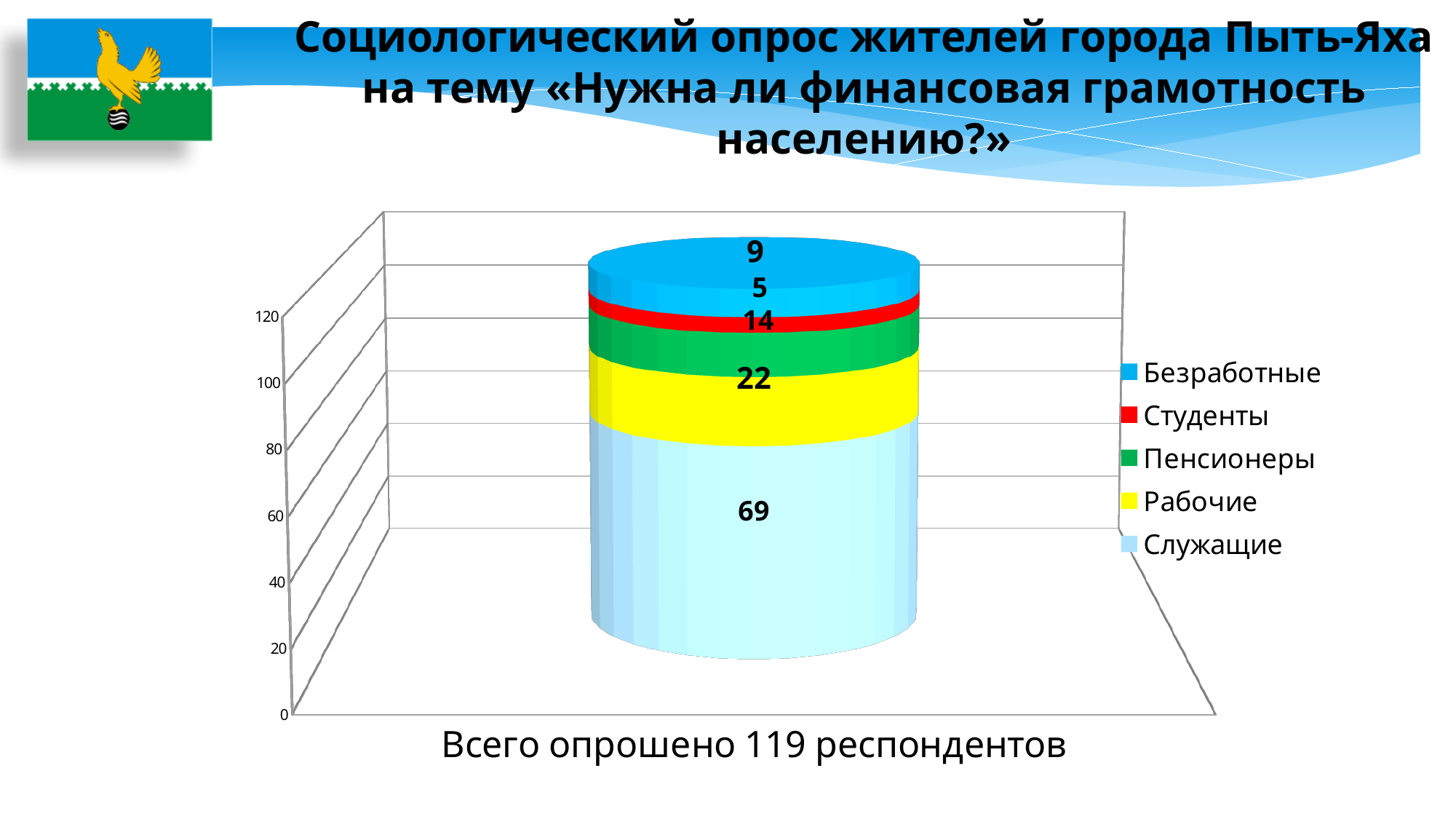
Which group has the smallest value in the chart? Студенты What kind of chart is shown on the slide? Stacked bar chart What value is shown for Безработные in the stacked bar? 9 What value is shown for Служащие in the stacked bar? 69 Which is larger, the value for Пенсионеры or the value for Безработные? Пенсионеры What value is shown for Рабочие in the stacked bar? 22 What value is shown for Пенсионеры in the stacked bar? 14 What is the total of the stacked bar? 119 Which group has the largest value in the chart? Служащие What value is shown for Студенты in the stacked bar? 5 What is the difference between the values for Служащие and Рабочие? 47 How many series does the legend list? 5